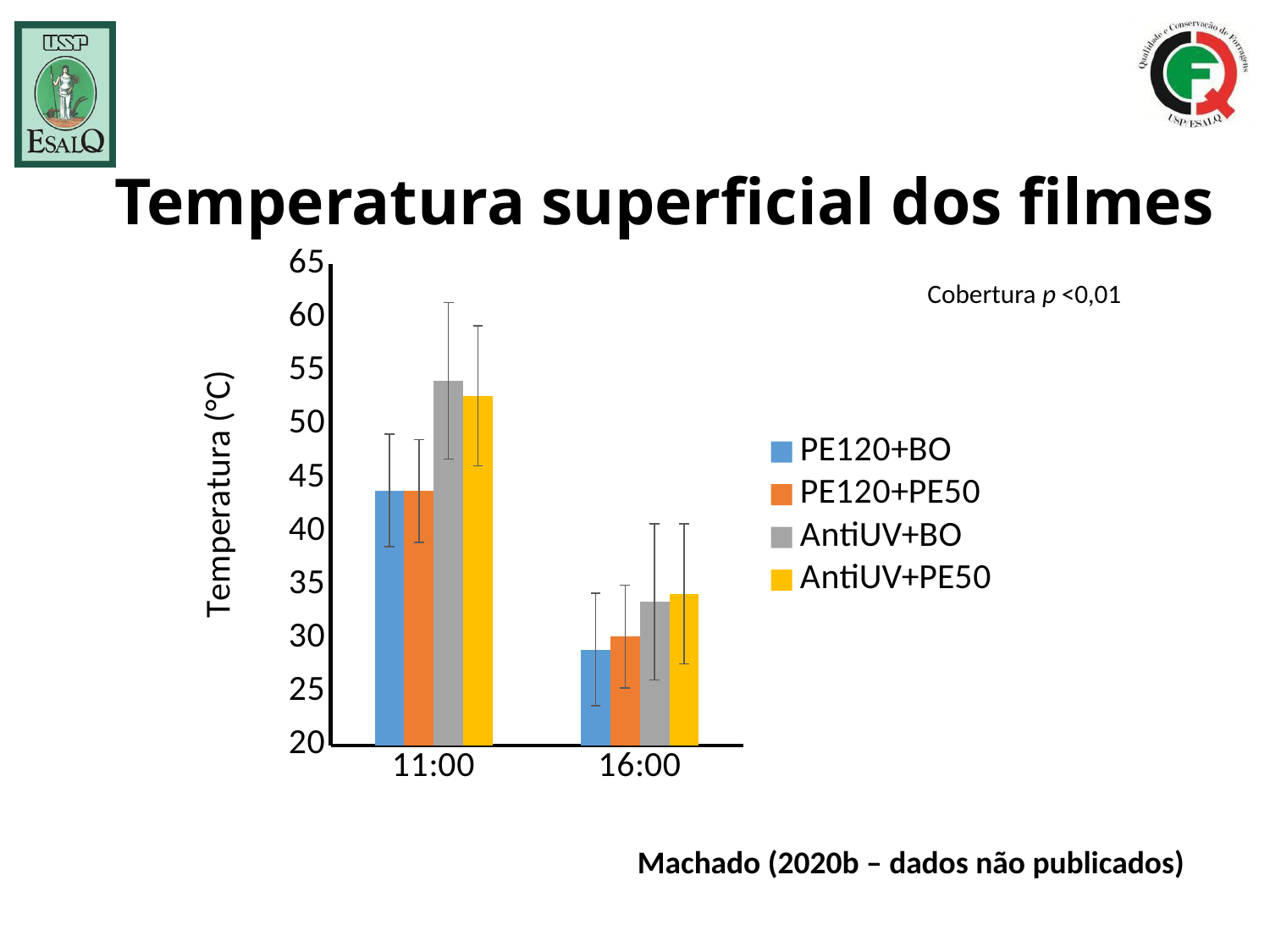
What kind of chart is shown on the slide? bar chart At 11:00, which is larger: PE120+BO or AntiUV+BO? AntiUV+BO Is the value for AntiUV+BO at 11:00 greater or less than 50? greater How many time categories are shown on the x axis? 2 Which series has the lowest value at 16:00? PE120+BO Is the value for PE120+BO at 16:00 greater or less than 30? less Is the value for AntiUV+BO larger at 11:00 or at 16:00? 11:00 What is the label of the y axis? Temperatura (°C) How many series does the legend list? 4 Do the temperatures rise or fall from 11:00 to 16:00? fall Is the value for AntiUV+PE50 at 16:00 greater or less than 35? less